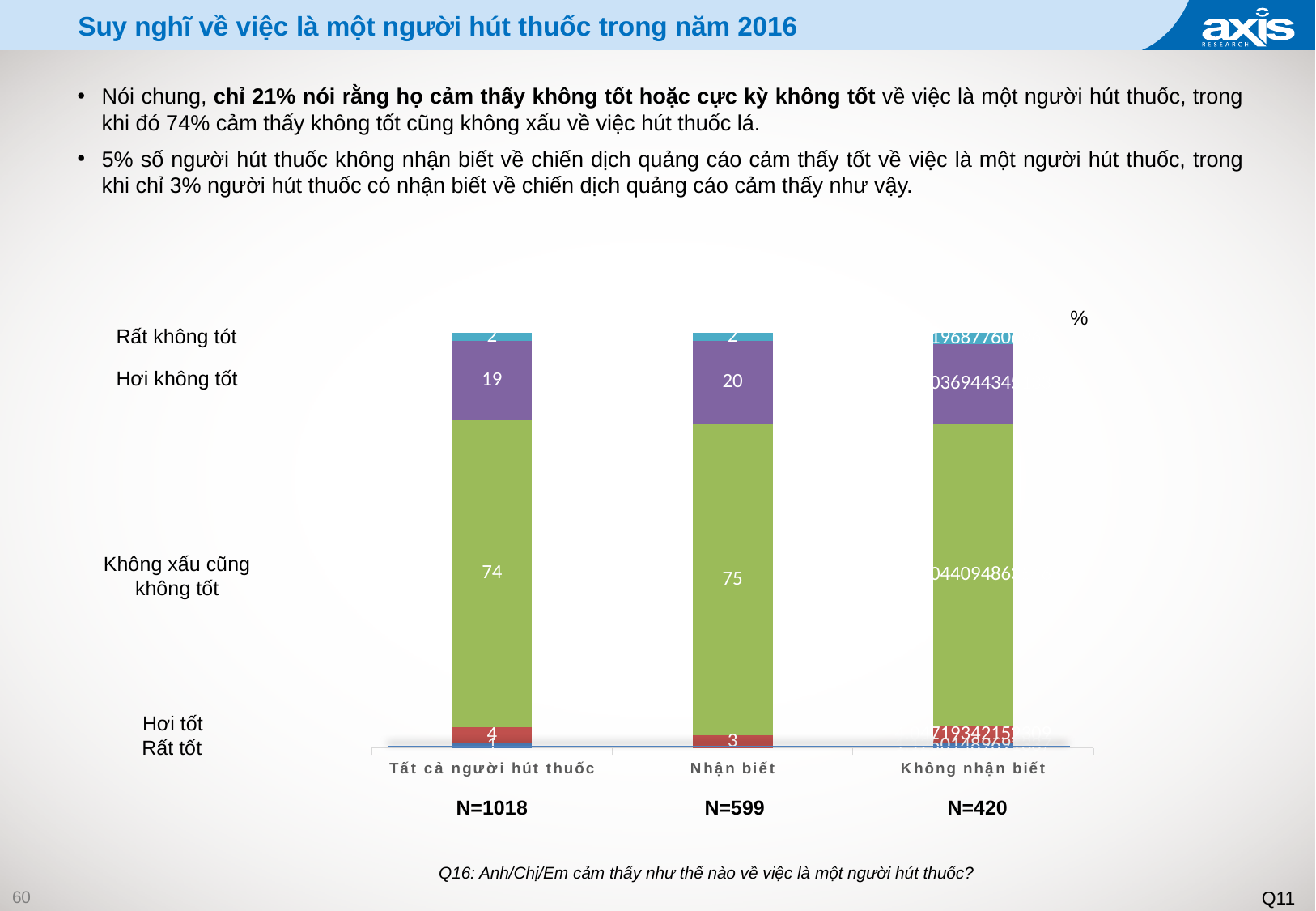
What is the sample size shown under the "Nhận biết" bar? N=599 What is the difference between the "Không xấu cũng không tốt" and "Hơi không tốt" values in the "Tất cả người hút thuốc" bar? 55 Which segment is the largest in the "Nhận biết" bar? Không xấu cũng không tốt Which is larger for "Không xấu cũng không tốt": "Tất cả người hút thuốc" or "Nhận biết"? Nhận biết What is the value for "Không xấu cũng không tốt" in the "Tất cả người hút thuốc" bar? 74 What is the value for "Hơi tốt" in the "Nhận biết" bar? 3 What kind of chart is shown on the slide? Stacked bar chart What is the value for "Rất không tốt" in the "Tất cả người hút thuốc" bar? 2 What is the value for "Hơi không tốt" in the "Nhận biết" bar? 20 What is the difference between the "Hơi không tốt" values for "Nhận biết" and "Tất cả người hút thuốc"? 1 What is the value for "Hơi tốt" in the "Tất cả người hút thuốc" bar? 4 How many categories (bars) are shown on the x axis? 3